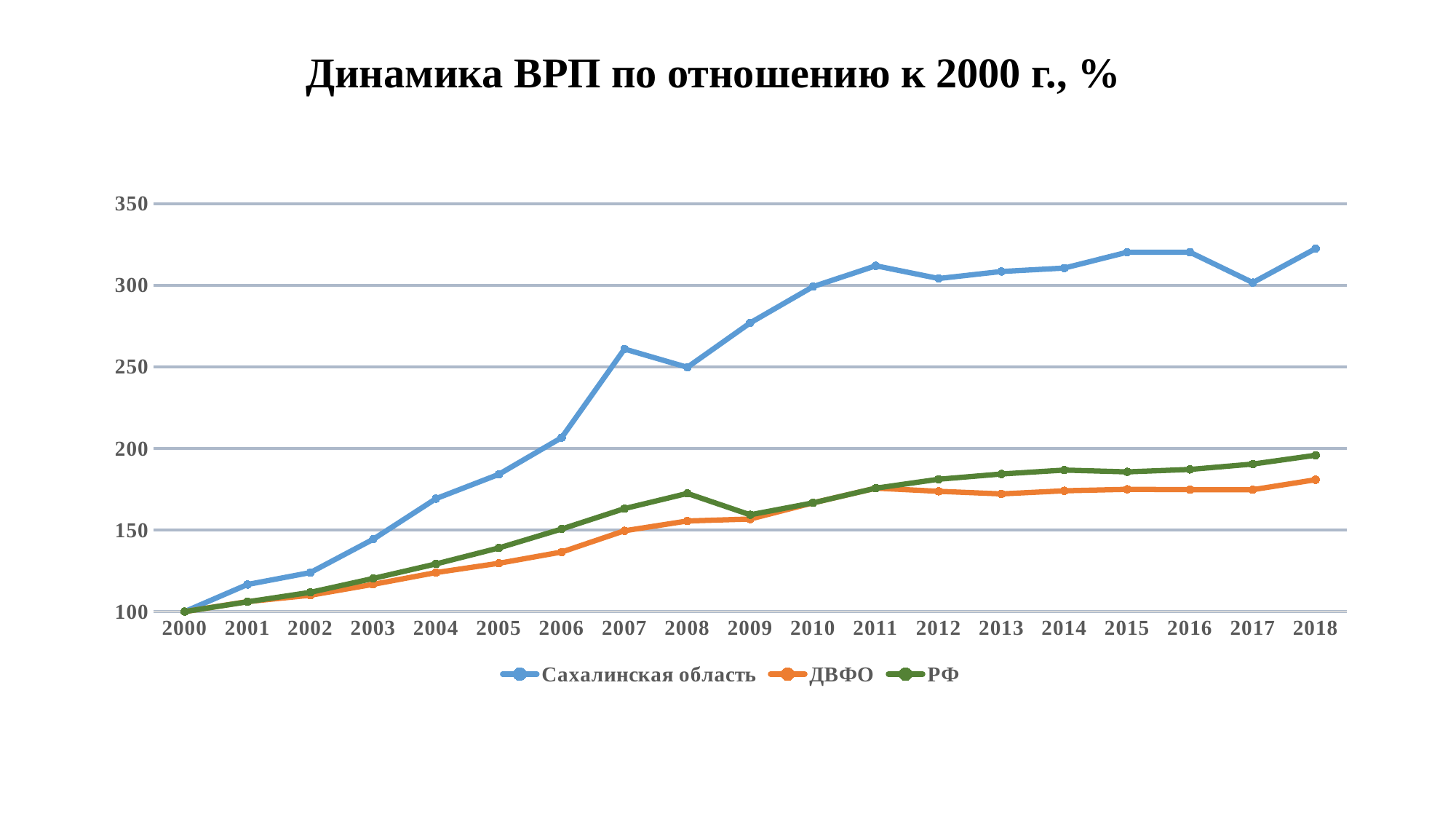
What is the value for Сахалинская область in 2000? 100 In 2018, which is higher, РФ or ДВФО? РФ What kind of chart is shown on the slide? line chart Is the value for ДВФО in 2018 greater or less than 200? less Which series has the highest value in 2018? Сахалинская область Is the value for Сахалинская область in 2018 greater or less than 300? greater Is the value for РФ in 2010 greater or less than 150? greater How many series does the legend list? 3 What is the title of the chart? Динамика ВРП по отношению к 2000 г., % Which series has the lowest value in 2013? ДВФО How many years are shown along the x axis? 19